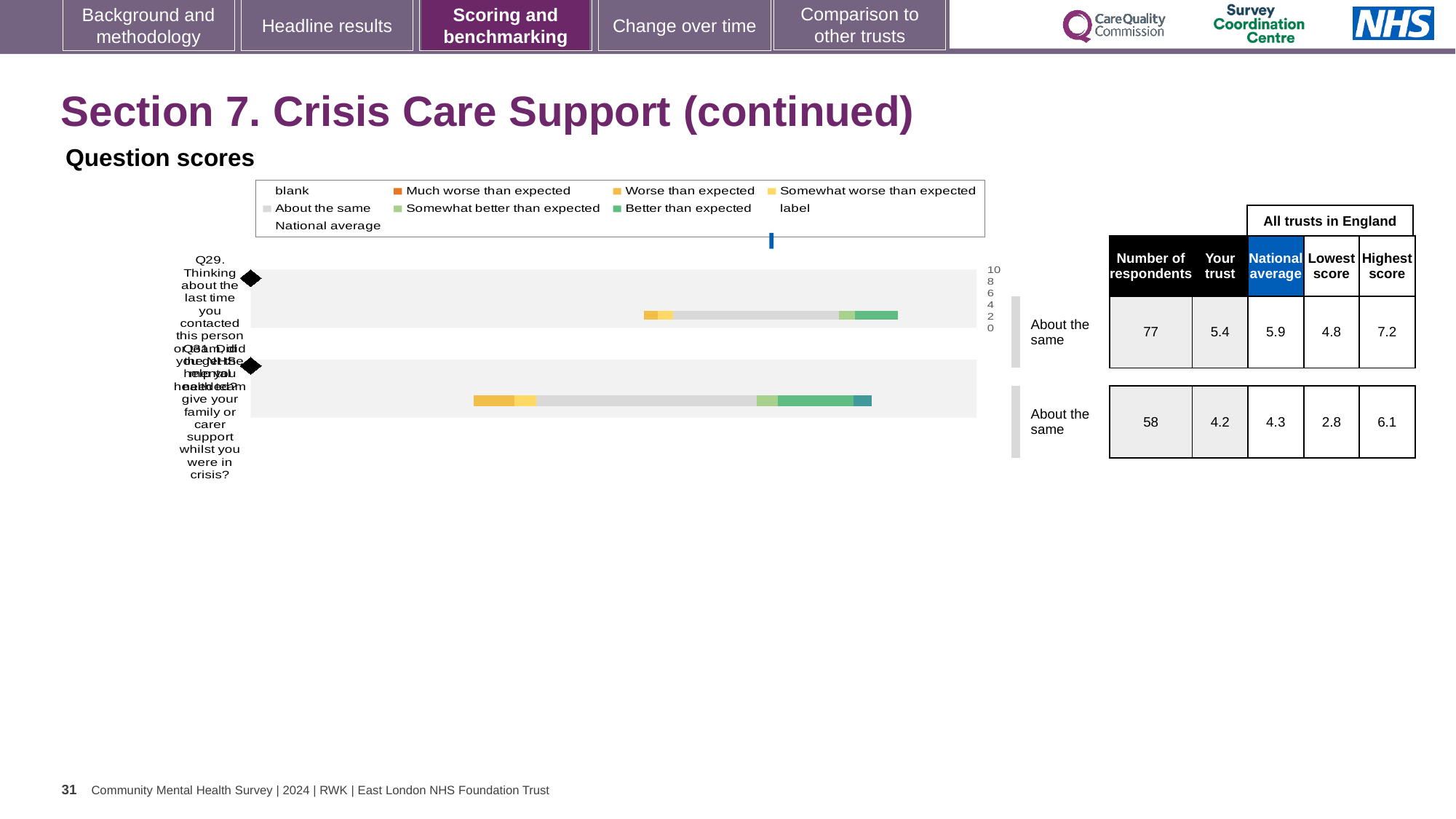
What is the 'Your trust' score for Q29? 5.4 What is the national average score for Q29? 5.9 What is the difference between the highest and lowest scores for Q31? 3.3 Which is larger for Q31: the 'Your trust' score or the national average? National average Which question has the higher 'Your trust' score, Q29 or Q31? Q29 What is the number of respondents for Q31? 58 What is the lowest score among all trusts in England for Q29? 4.8 What is the difference between the highest and lowest scores for Q29? 2.4 What is the highest score among all trusts in England for Q31? 6.1 How many questions (categories) are plotted in the chart? 2 What kind of chart is shown under 'Question scores'? bar chart What benchmark category is shown for both Q29 and Q31? About the same